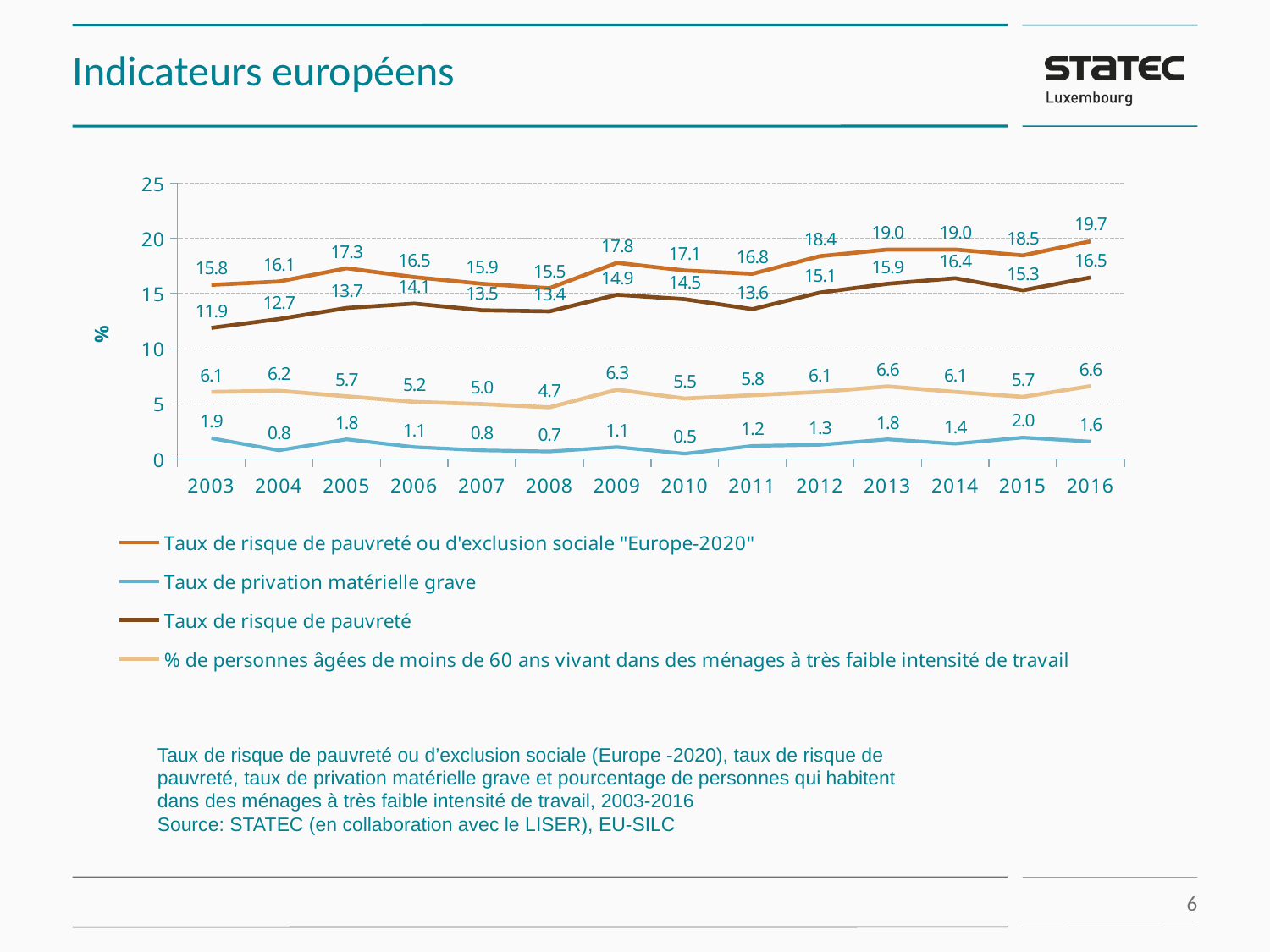
What is the label of the y axis? % What kind of chart is shown on the slide? Line chart What is the value of the "Taux de privation matérielle grave" series in 2010? 0.5 In which year does the "Taux de privation matérielle grave" series reach its highest value? 2015 Which is larger: the "Taux de risque de pauvreté" value in 2014 or in 2015? 2014 What is the value of the "Taux de risque de pauvreté" series in 2003? 11.9 What is the difference between the "Taux de risque de pauvreté" values in 2016 and 2003? 4.6 What is the value of the "% de personnes âgées de moins de 60 ans vivant dans des ménages à très faible intensité de travail" series in 2008? 4.7 How many series does the legend list? 4 How many years are shown on the x axis? 14 In which year is the "Taux de risque de pauvreté ou d'exclusion sociale "Europe-2020"" series at its lowest? 2008 What is the value of the "Taux de risque de pauvreté ou d'exclusion sociale "Europe-2020"" series in 2016? 19.7